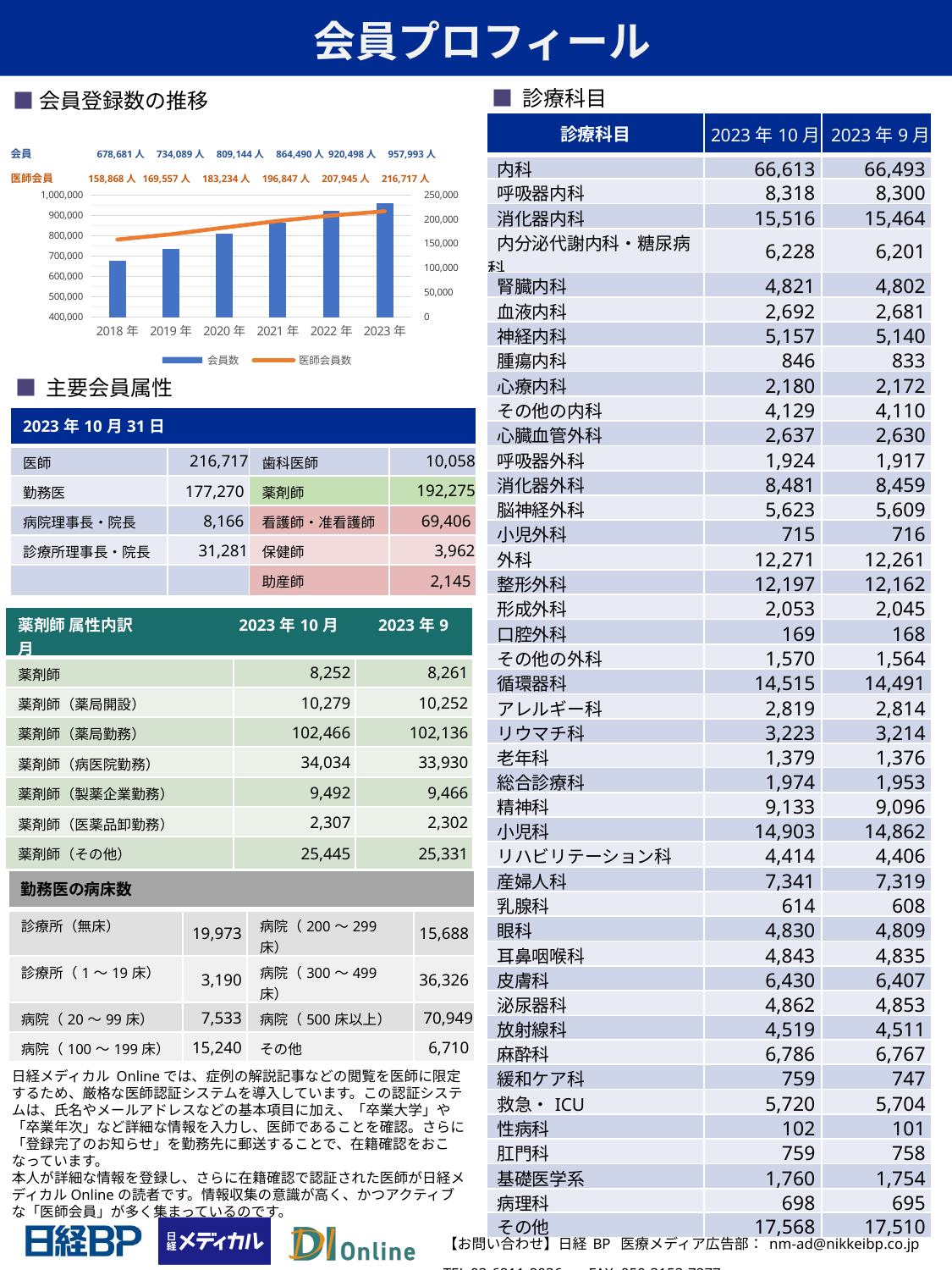
In the 会員登録数の推移 chart, which year has the highest 会員数? 2023年 In the 会員登録数の推移 chart, what is the difference in 会員数 between 2023年 and 2018年? 279,312人 How many years are shown on the x axis of the 会員登録数の推移 chart? 6 In the 会員登録数の推移 chart, what is the 医師会員数 value for 2018年? 158,868人 In the 会員登録数の推移 chart, is the 会員数 for 2018年 greater or less than 700,000? less In the 会員登録数の推移 chart, how much did 医師会員数 increase from 2022年 to 2023年? 8,772人 In the 会員登録数の推移 chart, which year has the lowest 医師会員数? 2018年 In the 会員登録数の推移 chart, what is the 会員数 value for 2023年? 957,993人 Does the 会員数 in the 会員登録数の推移 chart rise or fall from 2018年 to 2023年? rise In the 会員登録数の推移 chart, which year has the larger 会員数, 2019年 or 2020年? 2020年 In the 会員登録数の推移 chart, what is the 会員数 value for 2020年? 809,144人 How many series does the legend of the 会員登録数の推移 chart list? 2